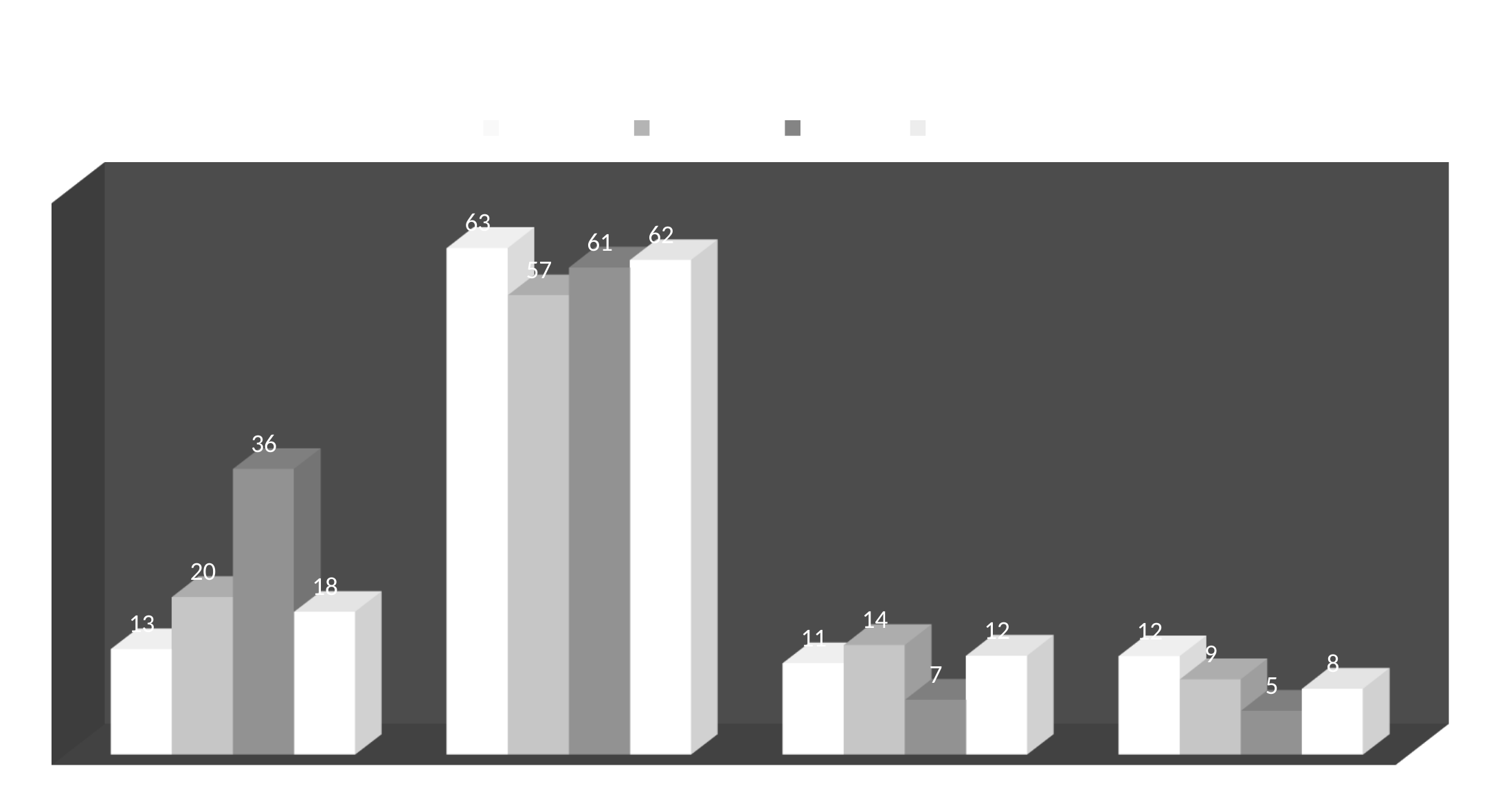
What kind of chart is shown on the slide? bar chart What is the difference between the first bar (63) and the second bar (57) in the second group? 6 What is the difference between the tallest bar in the first group (36) and the shortest bar in the first group (13)? 23 What is the highest value shown on the chart? 63 In the first group, which is larger: the second bar (20) or the fourth bar (18)? the second bar (20) What is the value of the third bar in the fourth (rightmost) group? 5 How many series does the legend list? 4 How many groups of bars are plotted along the x axis? 4 Which group of bars has the highest values overall? the second group from the left What is the lowest value shown on the chart? 5 What is the value of the first bar in the second group from the left? 63 What is the value of the tallest bar in the first (leftmost) group? 36